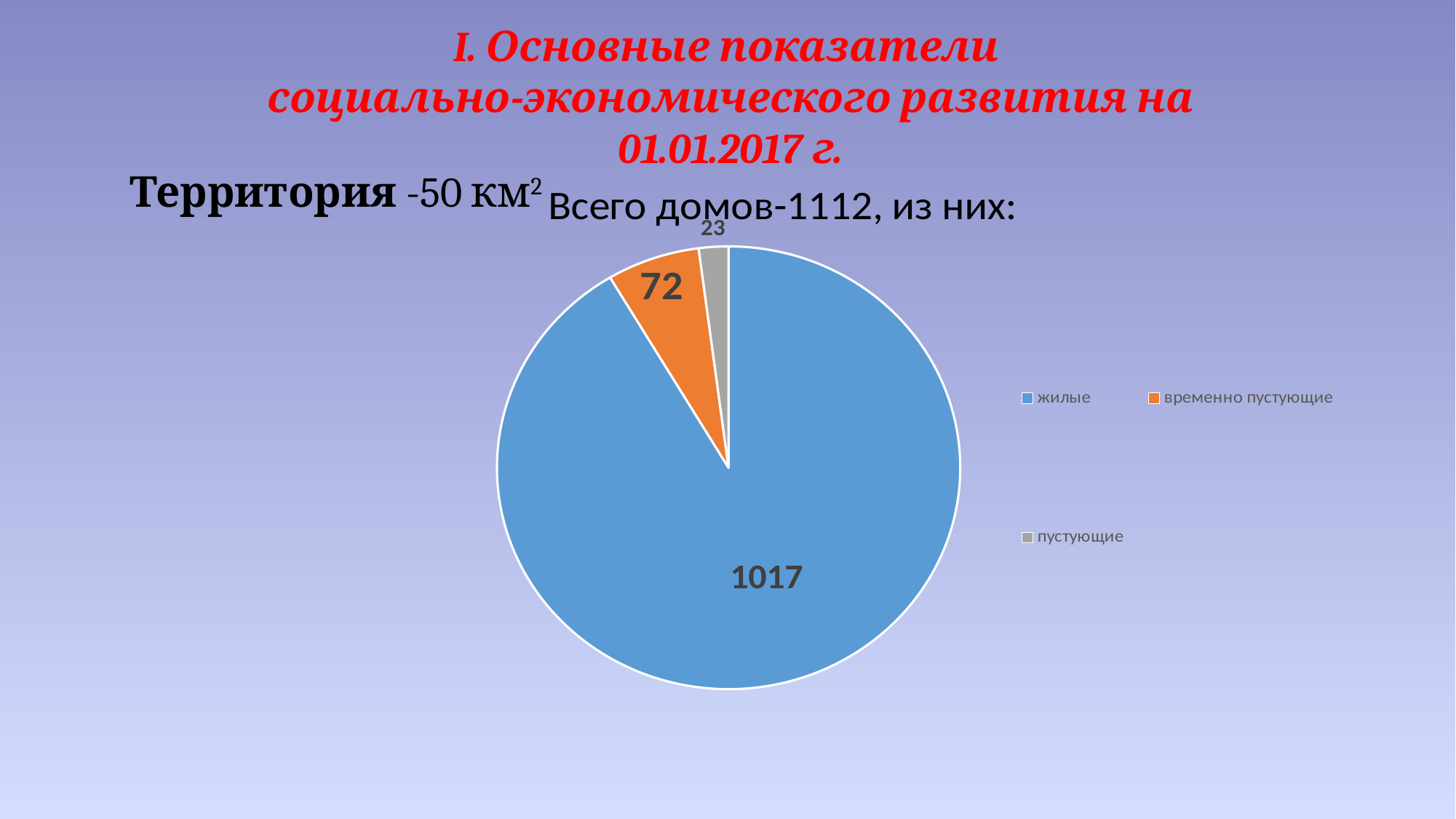
What kind of chart is shown on the slide? pie chart What is the difference between the values for жилые and временно пустующие? 945 Which category has the smallest slice in the pie chart? пустующие Which category has the largest slice in the pie chart? жилые What is the value for жилые in the pie chart? 1017 What is the difference between the values for временно пустующие and пустующие? 49 How many categories does the pie chart have? 3 Which is larger, the value for временно пустующие or the value for пустующие? временно пустующие What is the total of all slices in the pie chart? 1112 What is the title of the pie chart? Всего домов-1112, из них: What is the value for временно пустующие in the pie chart? 72 What is the value for пустующие in the pie chart? 23